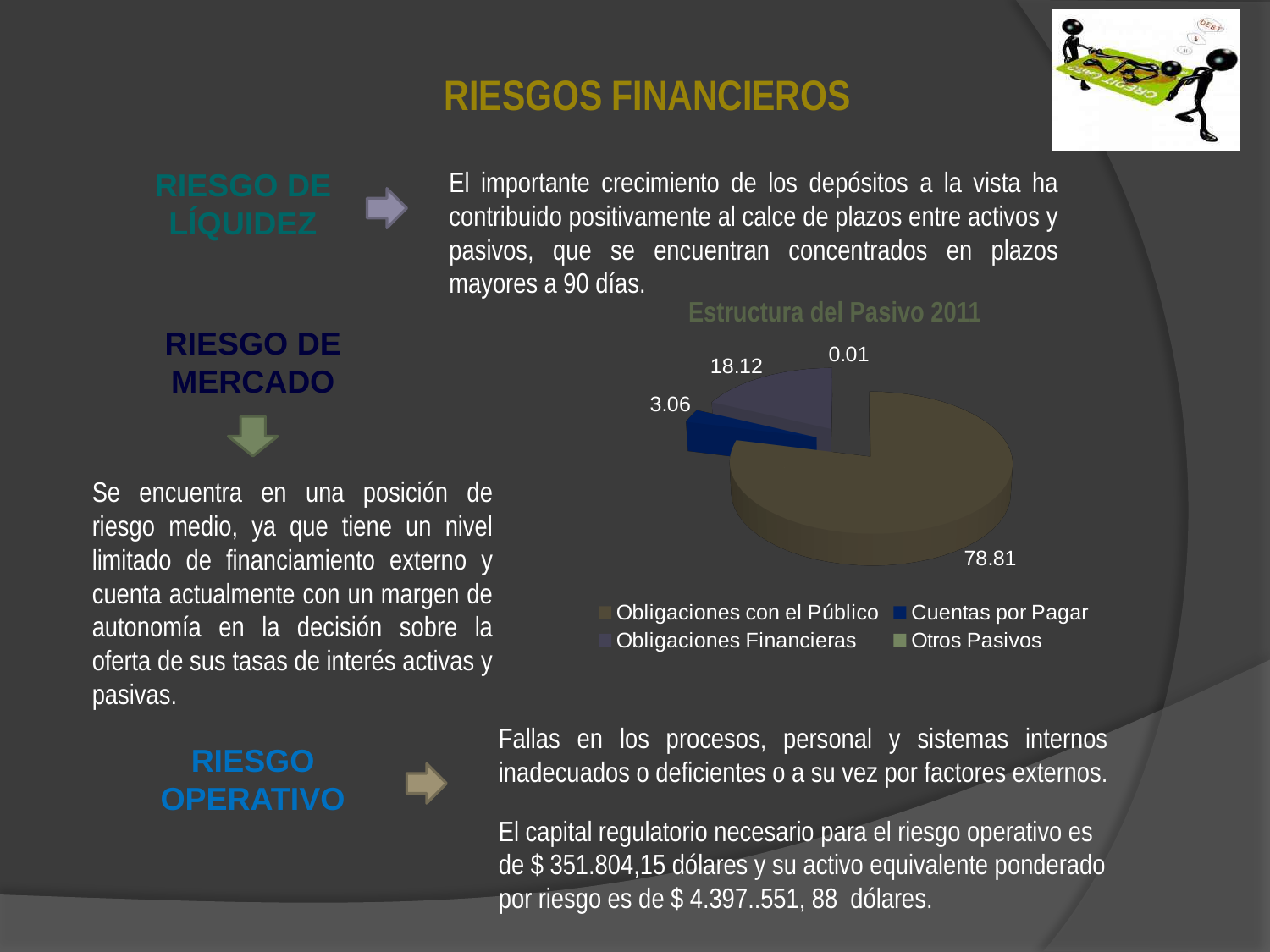
What is the title of the chart? Estructura del Pasivo 2011 What is the value shown for Cuentas por Pagar? 3.06 Which category has the smallest slice of the pie? Otros Pasivos Which is larger, Obligaciones Financieras or Cuentas por Pagar? Obligaciones Financieras What is the difference between the values for Obligaciones con el Público and Obligaciones Financieras? 60.69 How many categories does the legend of the pie chart list? 4 What is the value shown for Obligaciones con el Público? 78.81 What is the value shown for Obligaciones Financieras? 18.12 What is the value shown for Otros Pasivos? 0.01 Which category has the largest slice of the pie? Obligaciones con el Público What is the difference between the values for Cuentas por Pagar and Otros Pasivos? 3.05 What kind of chart is shown on the slide? pie chart